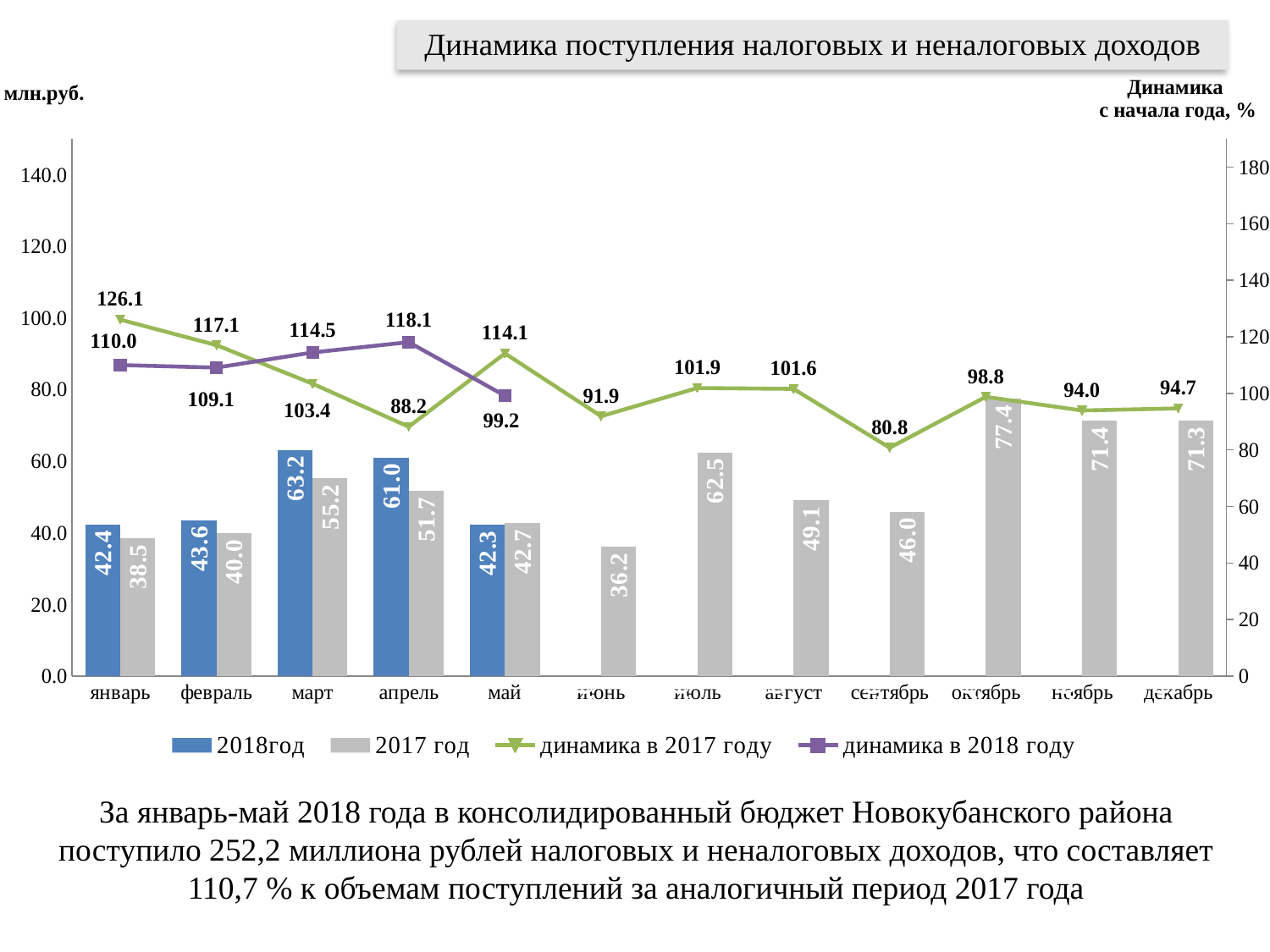
What is the value of the 2017 год series for октябрь? 77.4 Which month has the highest value in the 2017 год series? октябрь What is the value of the динамика в 2018 году line for апрель? 118.1 How many series does the legend list? 4 What is the difference between the 2018год and 2017 год values for март? 8.0 What is the value of the 2018год series for март? 63.2 For май, which is larger: the 2018год value or the 2017 год value? 2017 год Which month has the lowest value in the 2017 год series? июнь Which month has the highest value in the 2018год series? март What kind of chart is this? Combined bar and line chart Which month has the lowest value on the динамика в 2017 году line? сентябрь How many months are shown on the x axis? 12